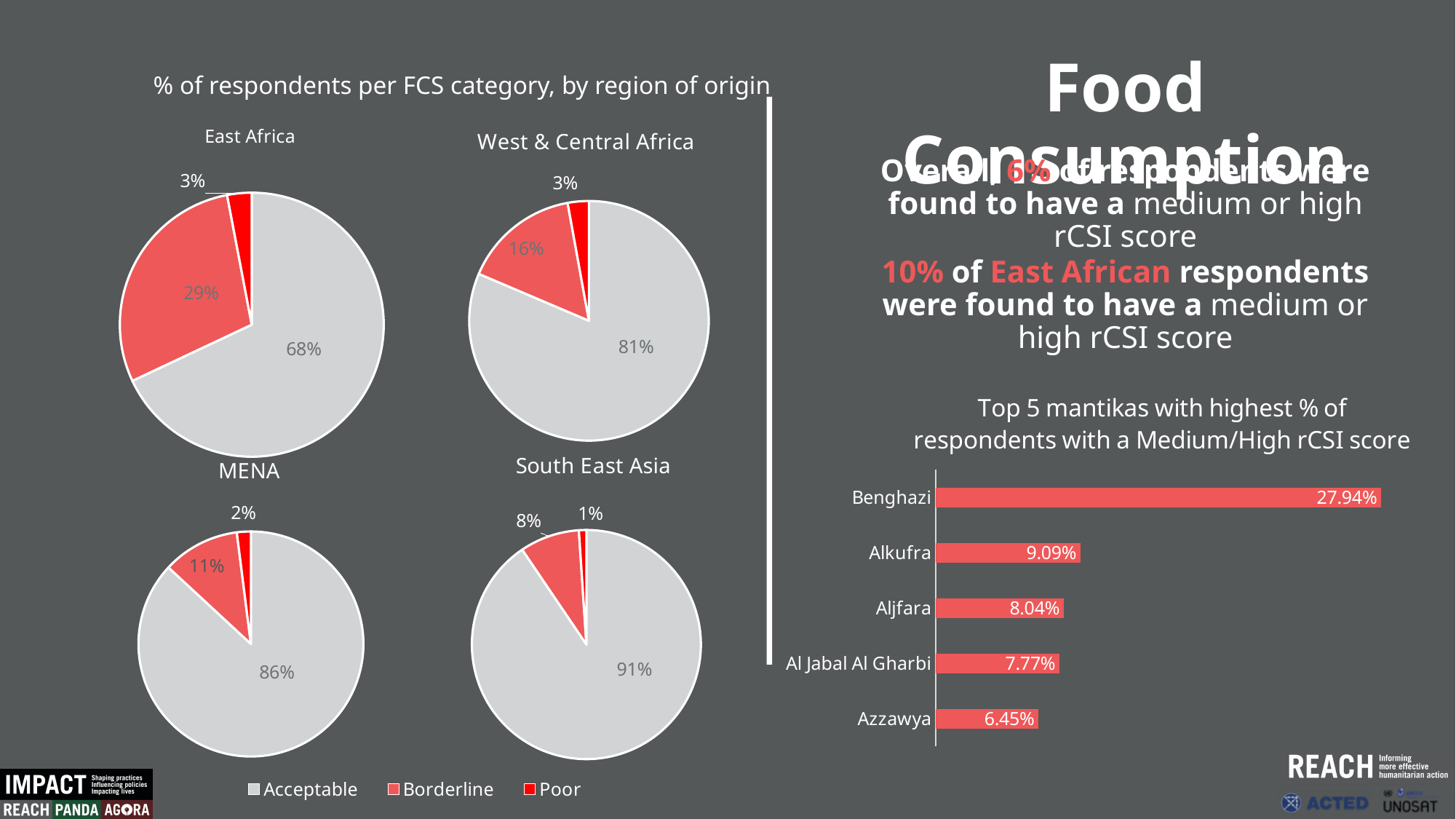
In the 'Top 5 mantikas' chart, what is the difference between Alkufra and Aljfara? 1.05% In the 'Top 5 mantikas' chart, which is larger, Al Jabal Al Gharbi or Azzawya? Al Jabal Al Gharbi In the 'Top 5 mantikas' chart, which mantika has the lowest value? Azzawya In the South East Asia pie chart, what percentage of respondents have an Acceptable FCS? 91% In the West & Central Africa pie chart, what percentage of respondents are in the Borderline category? 16% In the 'Top 5 mantikas' chart, what is the value for Benghazi? 27.94% In the East Africa pie chart, what percentage of respondents have an Acceptable FCS? 68% In the MENA pie chart, what percentage of respondents are in the Poor category? 2% In the East Africa pie chart, what is the difference between the Acceptable and Borderline shares? 39% Across the four FCS pie charts, which region has the largest Borderline share? East Africa What type of chart is the 'Top 5 mantikas' chart? Bar chart How many series does the legend of the FCS pie charts list? 3